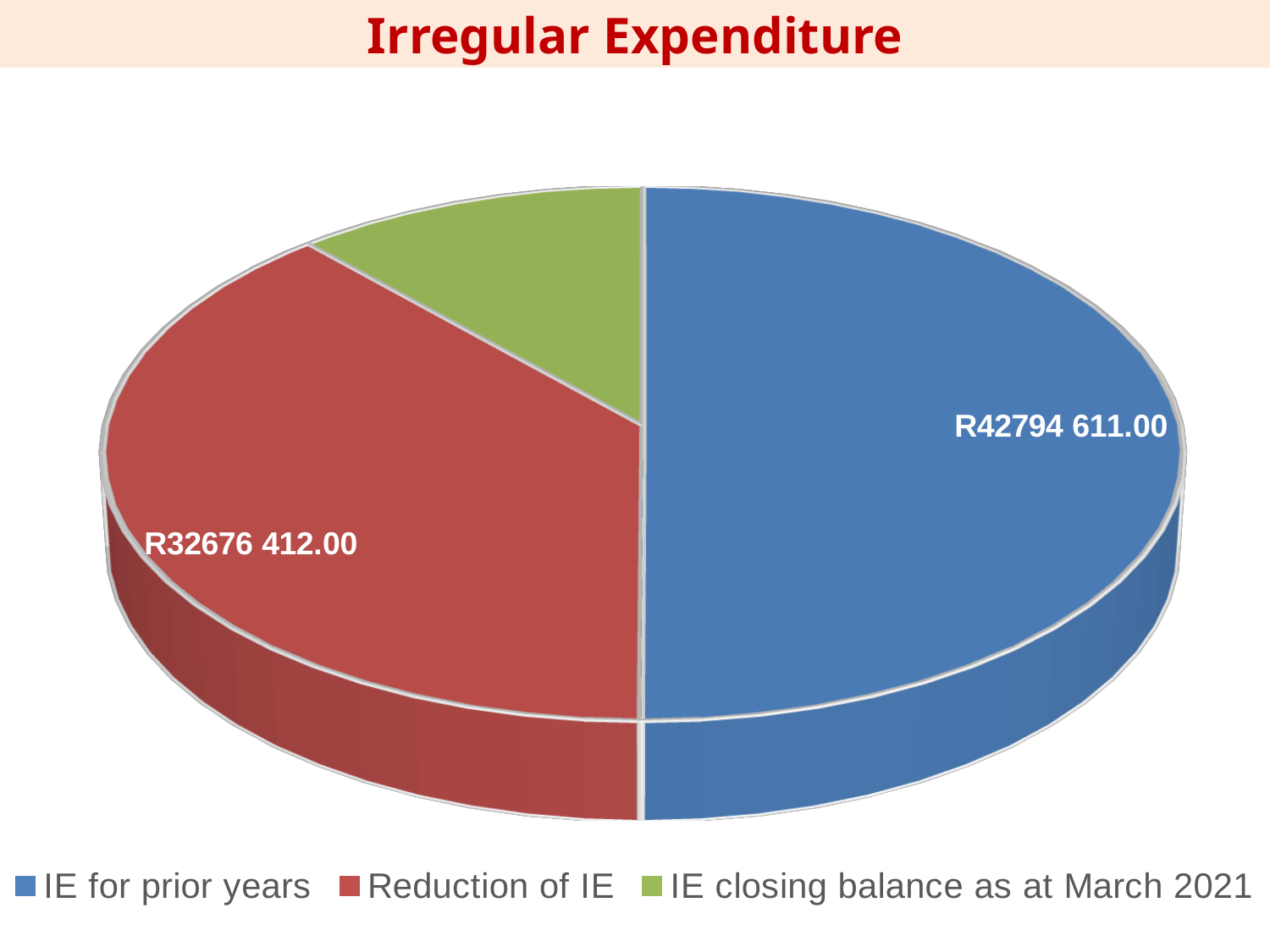
What is the value shown for IE for prior years? R42794 611.00 Which colour represents IE closing balance as at March 2021 in the legend? Green How many entries does the legend list? 3 What is the value shown for Reduction of IE? R32676 412.00 Which category has the largest slice of the pie? IE for prior years Which is larger, IE for prior years or Reduction of IE? IE for prior years How many slices does the pie chart have? 3 Which category has the smallest slice of the pie? IE closing balance as at March 2021 What kind of chart is shown on the slide? Pie chart What is the difference between the value for IE for prior years and the value for Reduction of IE? R10118 199.00 What is the title of the chart? Irregular Expenditure